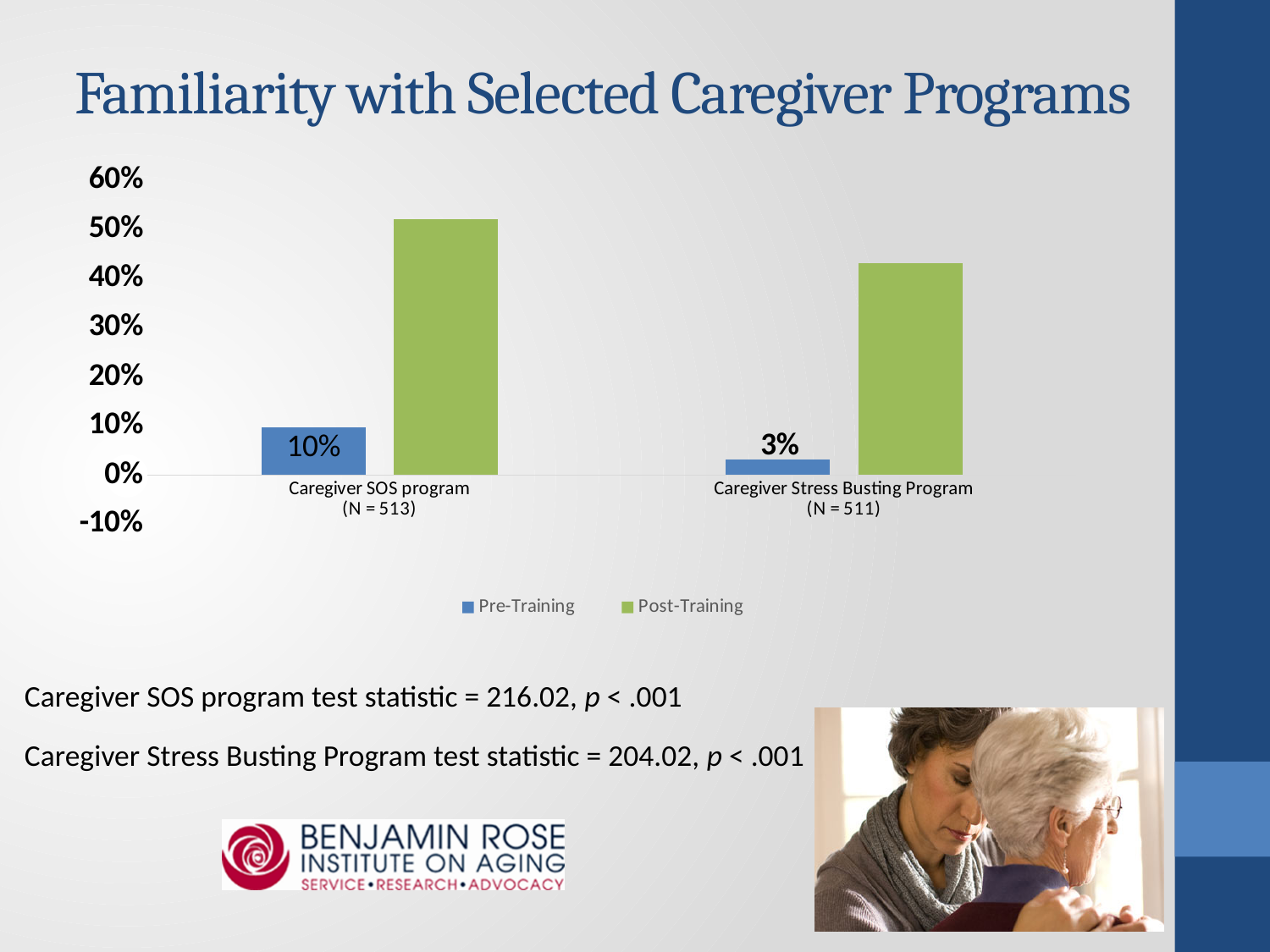
How many series does the legend list? 2 What is the Pre-Training value for the Caregiver SOS program? 10% Is the Post-Training value for the Caregiver Stress Busting Program greater or less than 40%? greater Which program has the higher Pre-Training value? Caregiver SOS program How many programs (categories) are shown on the chart? 2 Is the Post-Training value for the Caregiver Stress Busting Program greater or less than 50%? less What is the difference between the Pre-Training values for the Caregiver SOS program and the Caregiver Stress Busting Program? 7% Is the Post-Training value for the Caregiver SOS program greater or less than 40%? greater What kind of chart is shown on the slide? Bar chart Which program has the higher Post-Training value? Caregiver SOS program What is the Pre-Training value for the Caregiver Stress Busting Program? 3% What is the title of the chart on the slide? Familiarity with Selected Caregiver Programs